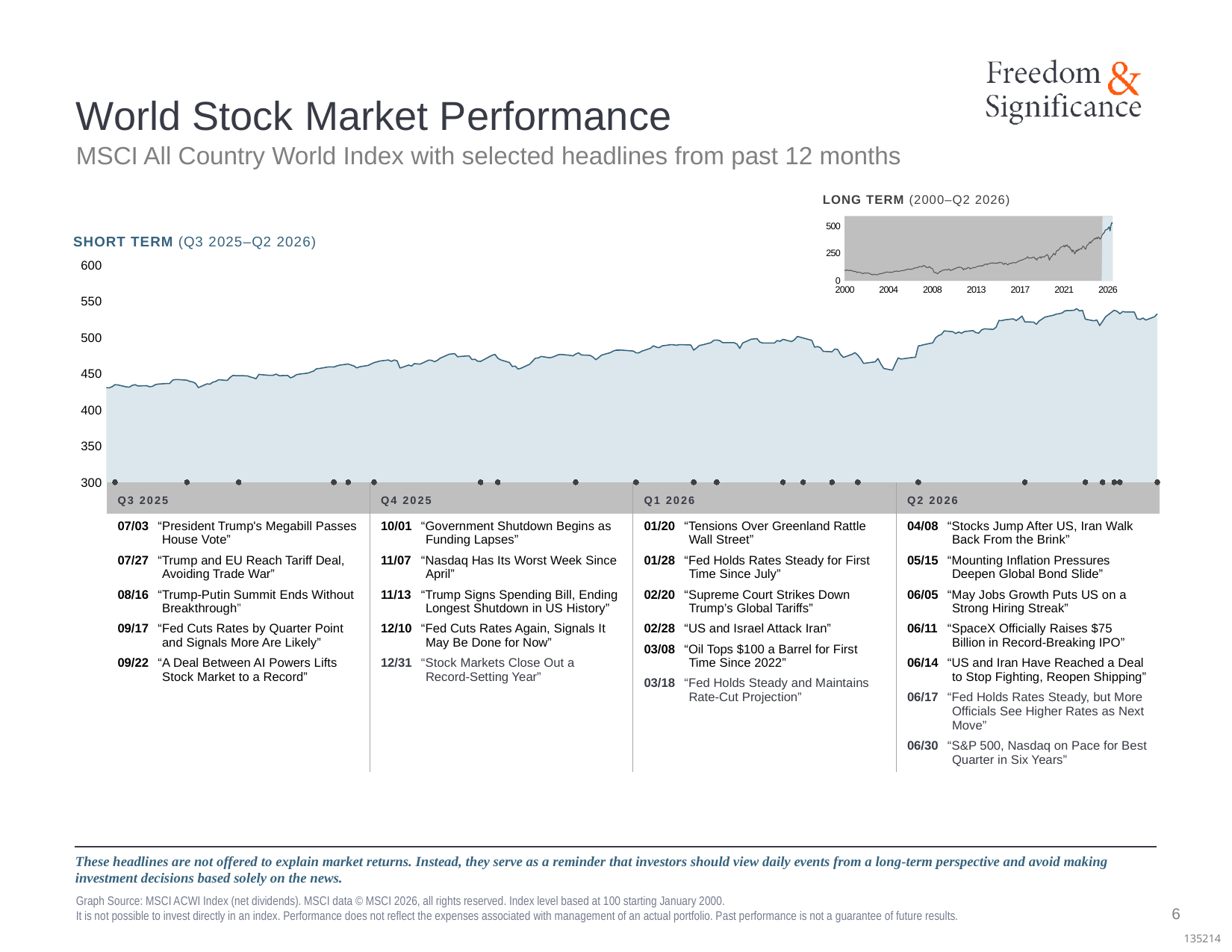
What period does the LONG TERM chart cover, according to its title? 2000–Q2 2026 In the LONG TERM chart, does the index level generally rise or fall from 2000 to 2026? rise In the SHORT TERM chart, is the index level higher at the end of Q2 2026 or at the start of Q3 2025? end of Q2 2026 How many quarters are labelled along the x axis of the SHORT TERM chart? 4 In the SHORT TERM chart, is the index level at the start of Q3 2025 greater or less than 450? less In the LONG TERM chart, is the index level in 2000 greater or less than 250? less In the SHORT TERM chart, is the highest index level reached greater or less than 550? less What is the lowest value shown on the y axis of the SHORT TERM chart? 300 In the SHORT TERM chart, does the index level generally rise or fall from Q3 2025 to Q2 2026? rise What kind of chart is the SHORT TERM (Q3 2025–Q2 2026) chart? line chart